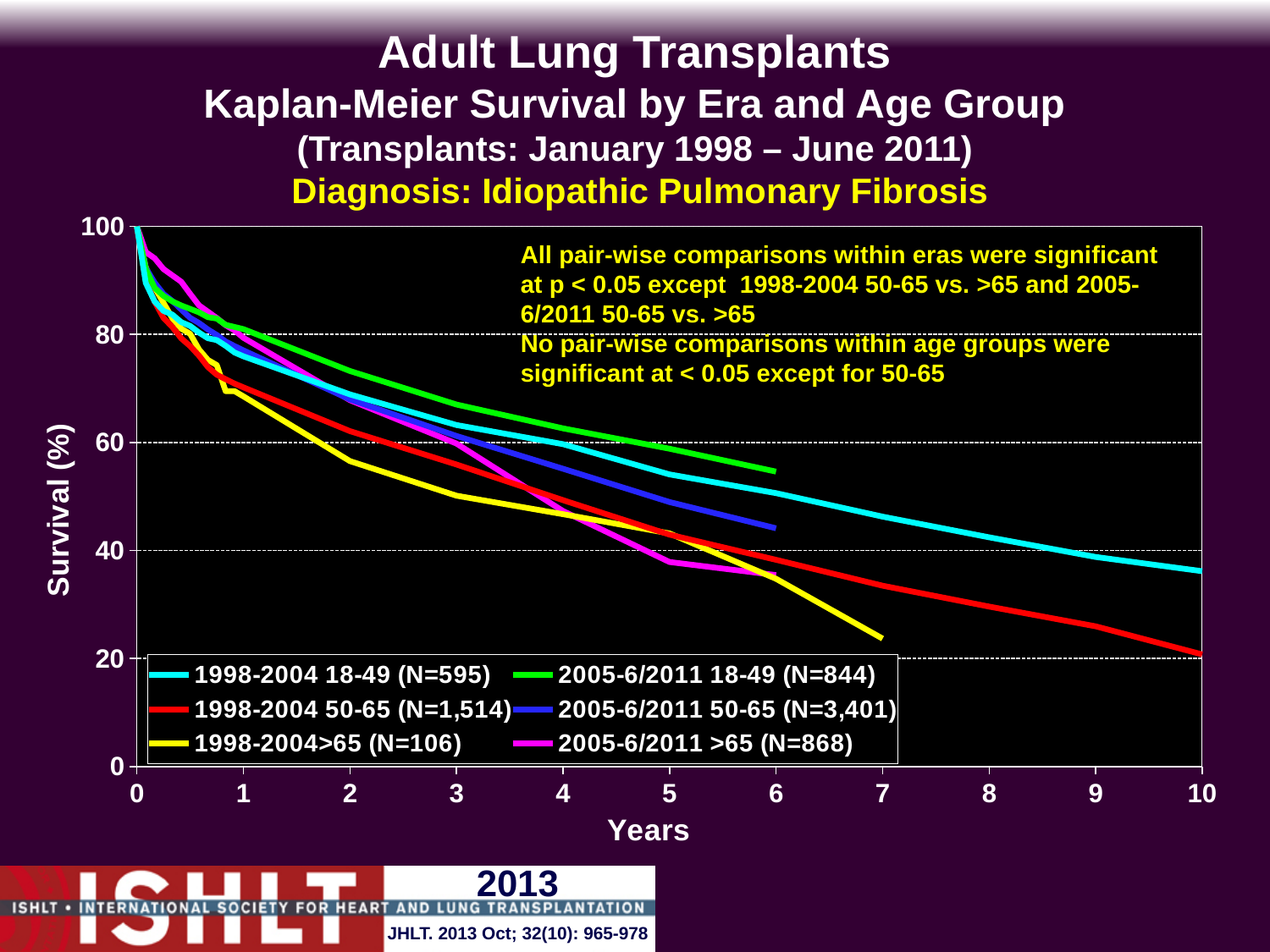
Do the survival curves rise or fall as years increase? fall Is the survival value for 2005-6/2011 >65 at 6 years greater or less than 40? less What is the N shown in the legend for the 2005-6/2011 50-65 series? N=3,401 At 10 years, which has higher survival: 1998-2004 18-49 or 1998-2004 50-65? 1998-2004 18-49 Is the survival value for 2005-6/2011 50-65 at 6 years greater or less than 40? greater Is the survival value for 1998-2004 >65 at 7 years greater or less than 20? greater How many series does the legend list? 6 At 6 years, which has higher survival: 2005-6/2011 18-49 or 2005-6/2011 >65? 2005-6/2011 18-49 What kind of chart is shown on the slide? line chart What diagnosis does the chart cover, according to the title? Idiopathic Pulmonary Fibrosis